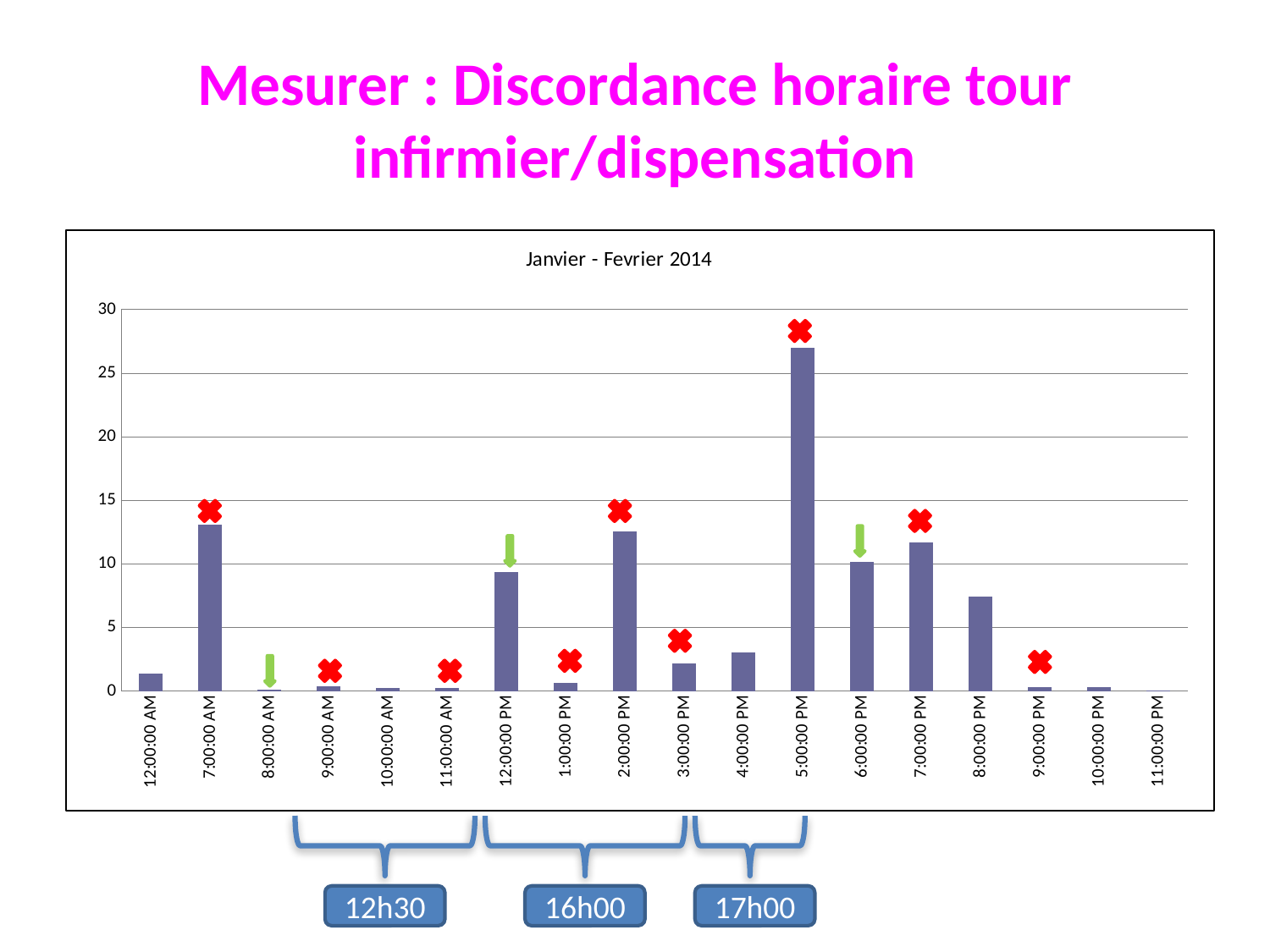
How many time categories are shown on the x axis of the chart? 18 Which is larger, the value for 5:00:00 PM or the value for 7:00:00 AM? 5:00:00 PM What kind of chart is shown on the slide? bar chart Is the value for 2:00:00 PM greater or less than 10? greater Is the value for 8:00:00 PM greater or less than 10? less Which is larger, the value for 12:00:00 PM or the value for 3:00:00 PM? 12:00:00 PM Is the value for 5:00:00 PM greater or less than 25? greater What is the title of the chart? Janvier - Fevrier 2014 What is the highest value shown on the vertical axis of the chart? 30 Which time category has the highest bar? 5:00:00 PM